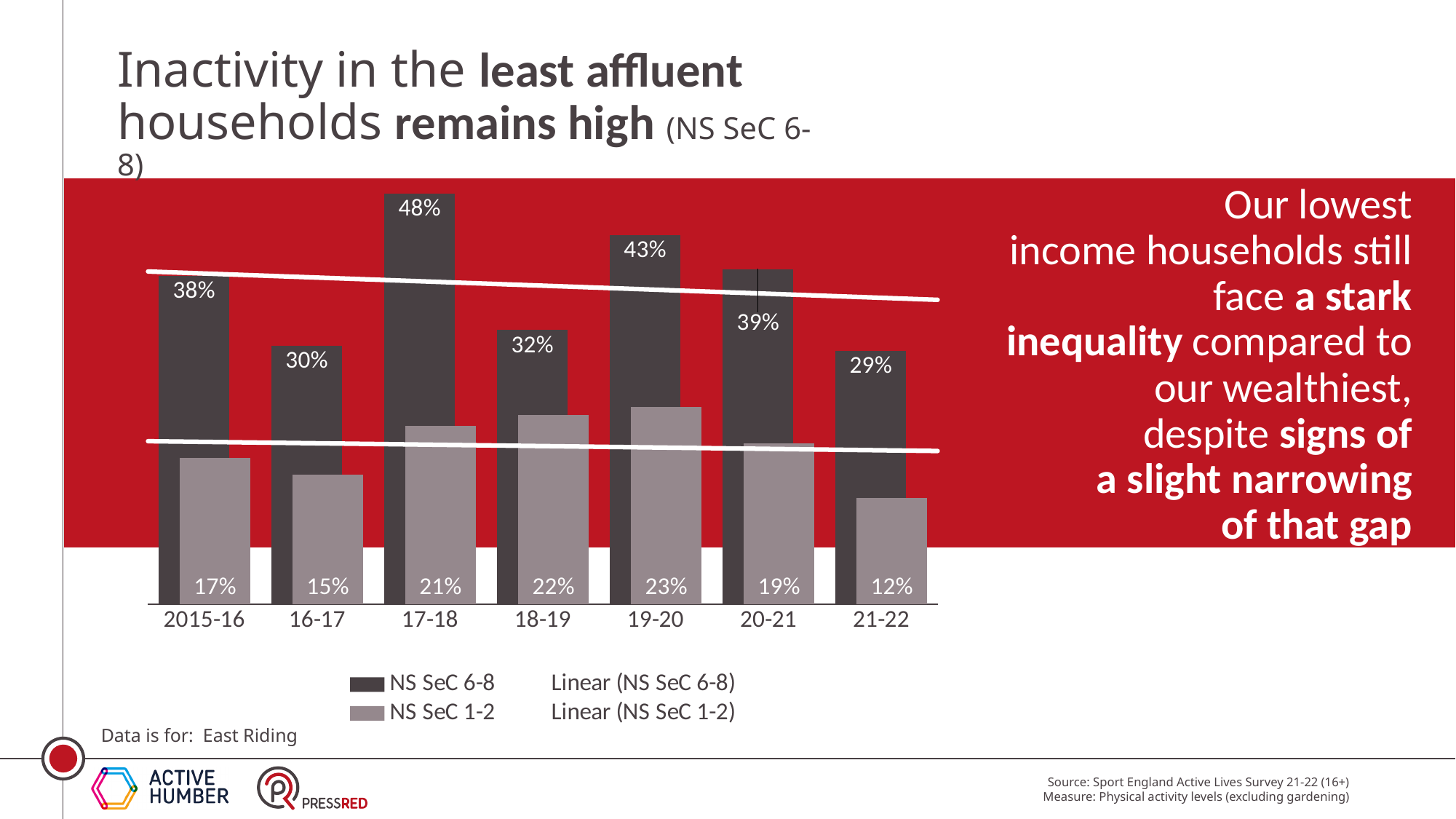
What is the value for NS SeC 6-8 in 2015-16? 38% What is the difference between the NS SeC 6-8 and NS SeC 1-2 values in 19-20? 20% In which year is the NS SeC 1-2 value lowest? 21-22 Does the NS SeC 6-8 linear trend line rise or fall from 2015-16 to 21-22? Fall Which is larger in 20-21: the NS SeC 6-8 value or the NS SeC 1-2 value? NS SeC 6-8 What is the value for NS SeC 6-8 in 17-18? 48% What kind of chart is shown? Bar chart What is the value for NS SeC 1-2 in 21-22? 12% How many entries does the legend list? 4 In which year is the NS SeC 6-8 value highest? 17-18 How many years are shown on the x axis? 7 Which area is the data for, according to the slide? East Riding